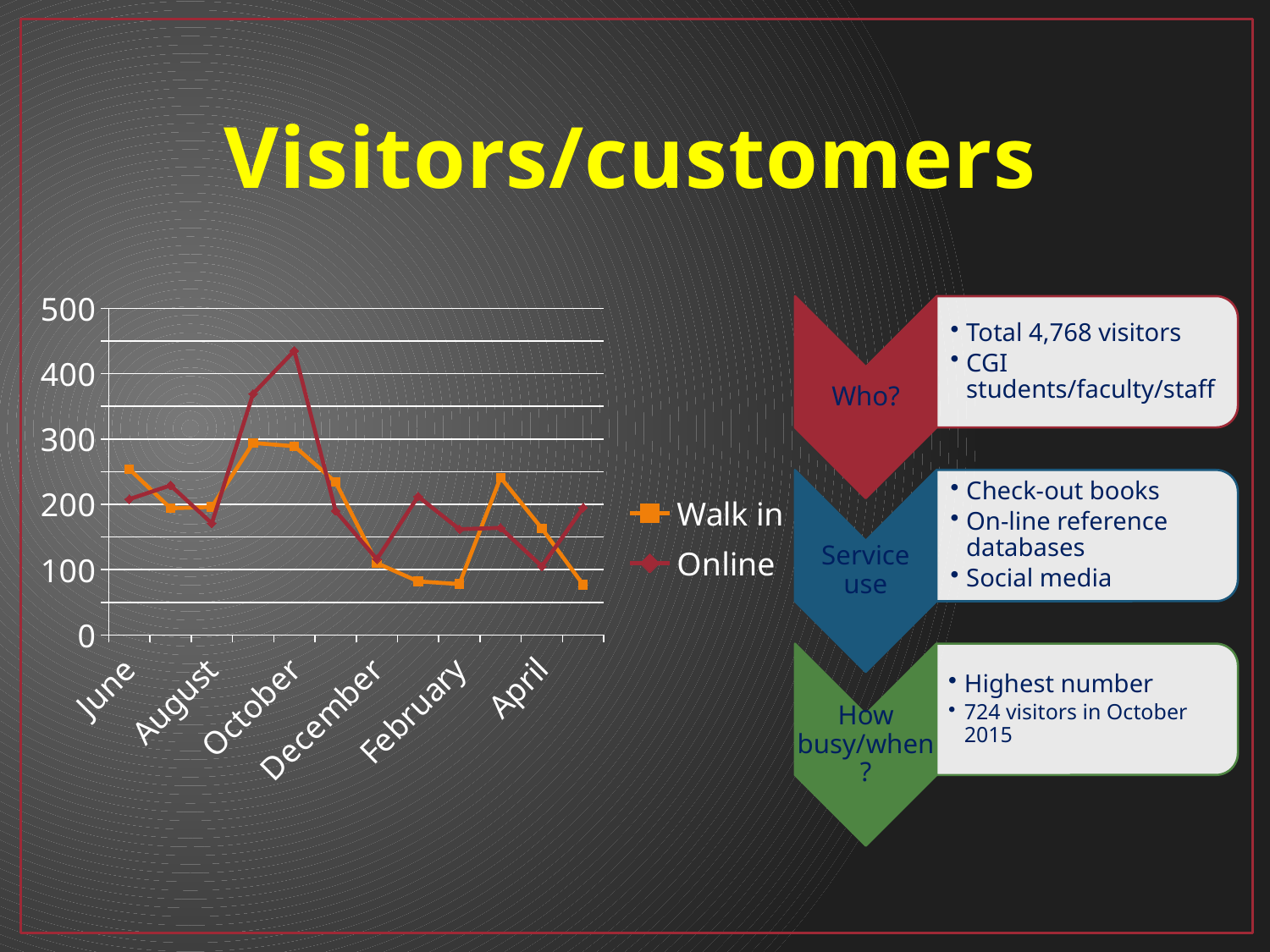
Is the Walk in value for June greater or less than 200? greater In June, which series has the larger value, Walk in or Online? Walk in Does the Walk in series rise or fall from October to December? fall Is the Online value for August greater or less than 200? less Does the Online series rise or fall from August to October? rise What are the two series named in the chart legend? Walk in and Online What kind of chart is shown on the slide? line chart In which month does the Online series reach its highest value? October Is the Walk in value for February greater or less than 100? less How many series does the chart legend list? 2 In October, which series has the larger value, Walk in or Online? Online